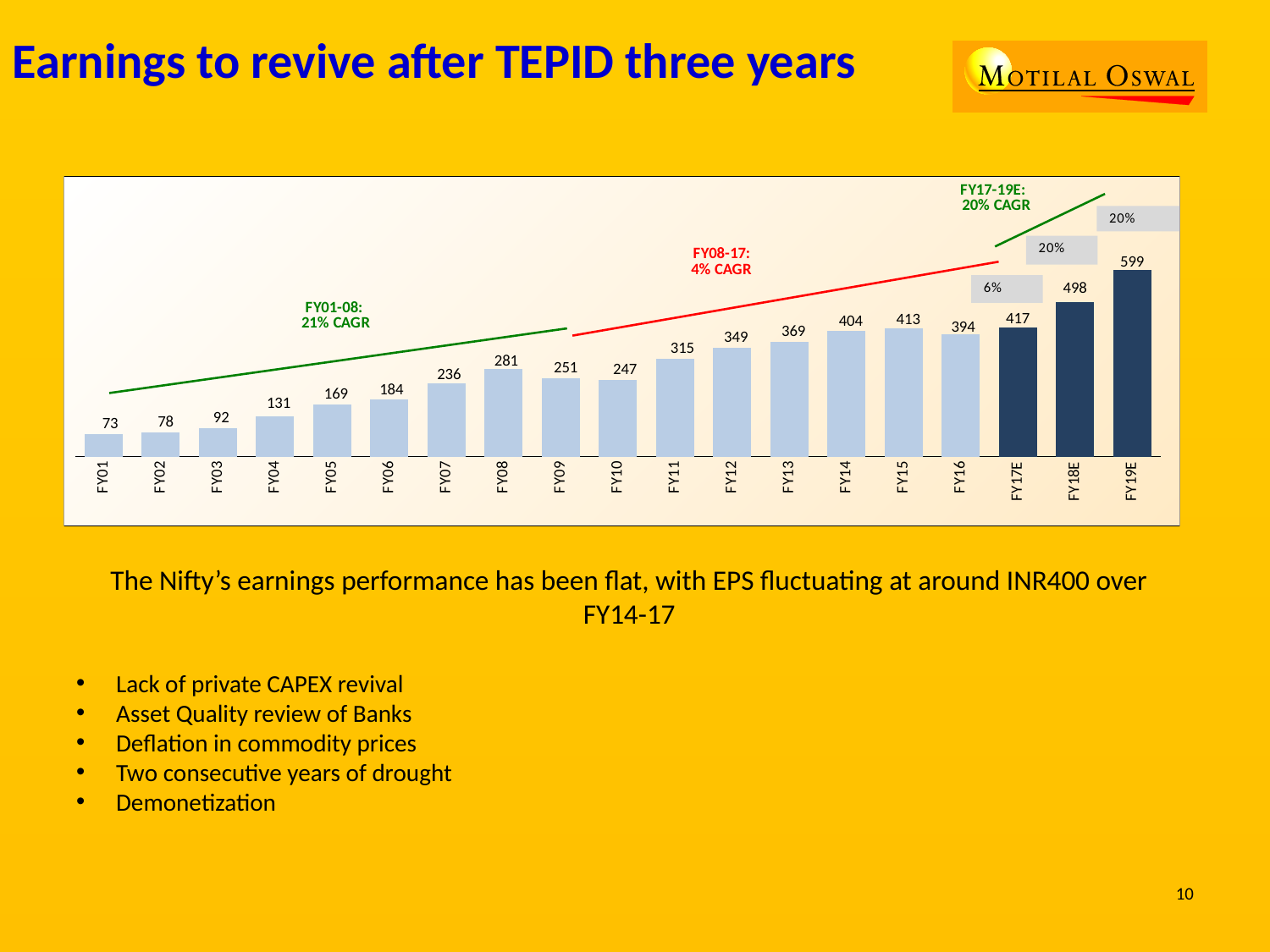
What is the value shown for FY14? 404 What kind of chart is shown on the slide? Bar chart How many fiscal years are plotted on the chart? 19 Do the values rise or fall from FY08 to FY10? Fall What is the value shown for FY08? 281 What CAGR does the chart annotation give for the FY08-17 period? 4% CAGR What growth percentage is labelled above the FY17E bar? 6% What is the difference between the values for FY18E and FY17E? 81 What is the value shown for FY19E? 599 Which is larger, the value for FY15 or the value for FY16? FY15 Which fiscal year has the highest value on the chart? FY19E Which fiscal year has the lowest value on the chart? FY01